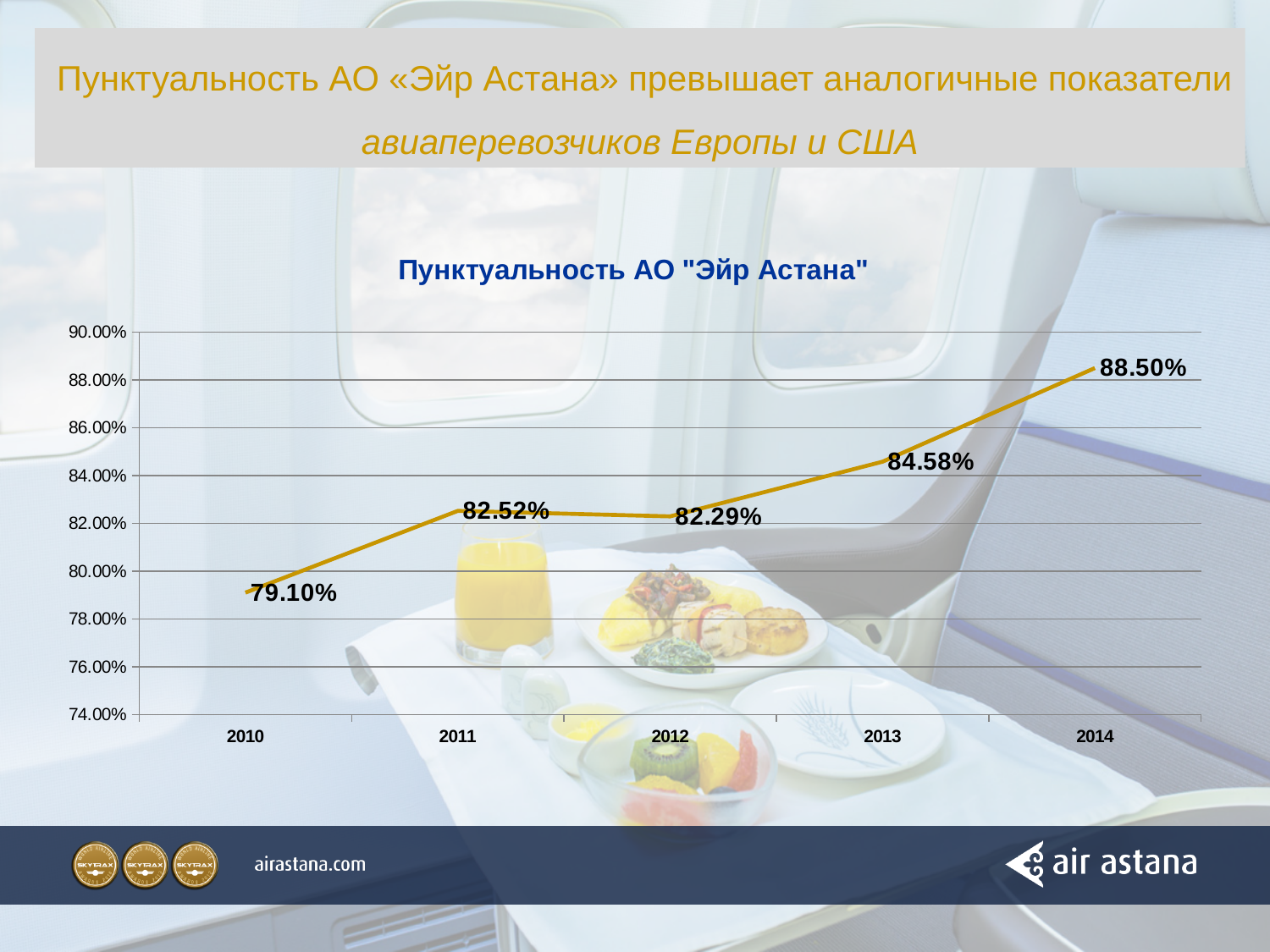
How many years are plotted on the chart? 5 Which year has the lowest punctuality value? 2010 What is the difference between the punctuality values for 2014 and 2010? 9.40% Does the punctuality value rise or fall from 2011 to 2012? fall What was the punctuality value for 2012? 82.29% What kind of chart is shown on the slide? line chart What is the title of the chart? Пунктуальность АО "Эйр Астана" Is the value for 2013 greater or less than 84.00%? greater Which year has the larger punctuality value, 2011 or 2013? 2013 What was the punctuality value for 2014? 88.50% Which year has the highest punctuality value? 2014 What was the punctuality value for 2010? 79.10%